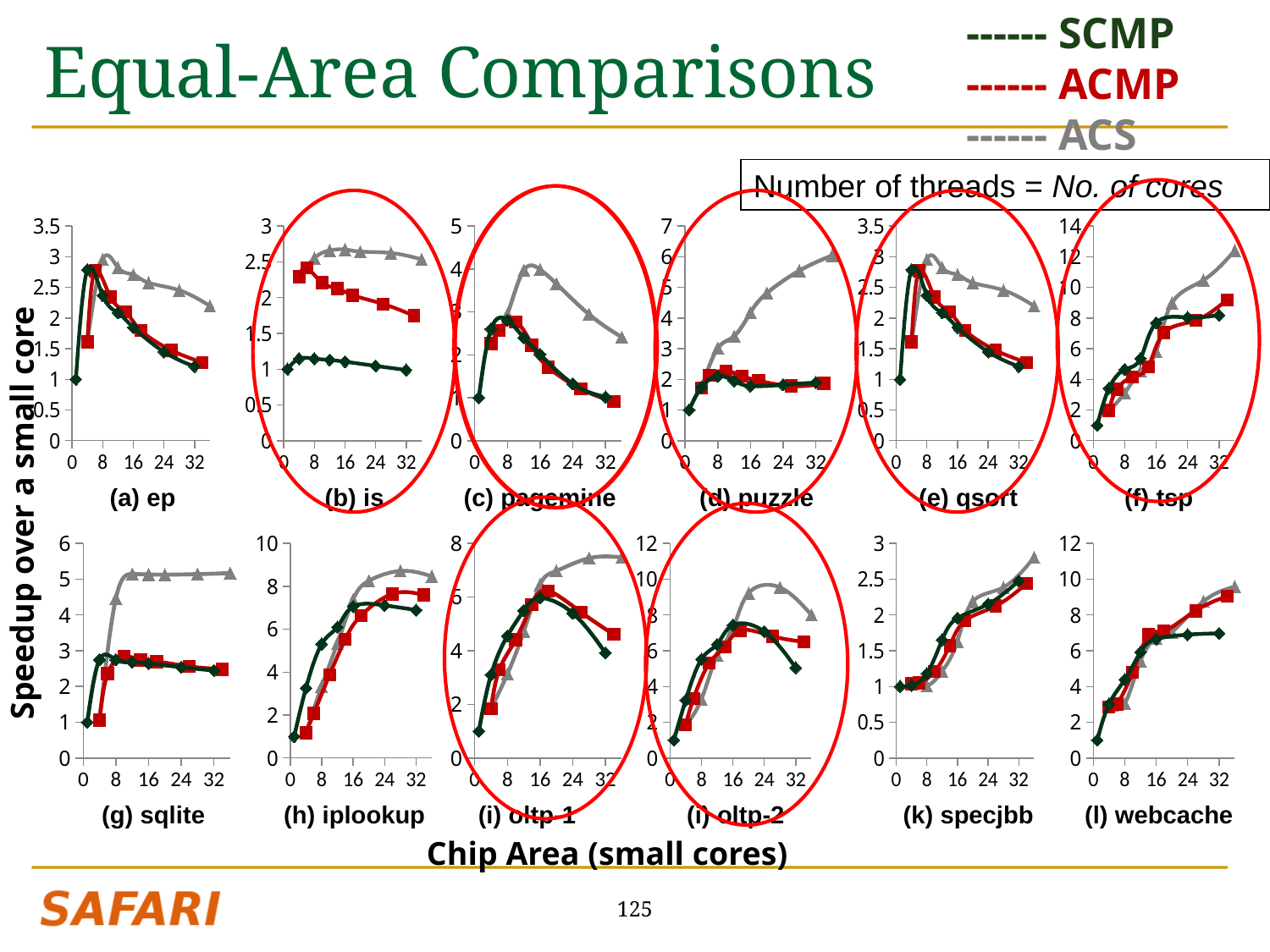
In the (k) specjbb chart, do the values rise or fall as chip area increases? rise How many benchmark panels (charts) are shown on the slide? 12 In the (b) is chart, is the ACS value at chip area 16 greater or less than 2? greater What is the label of the shared x axis? Chip Area (small cores) What kind of chart is used for the (a) ep panel? line chart In the (f) tsp chart, is the ACS value at chip area 32 greater or less than 10? greater How many series does the legend list? 3 In the (b) is chart, which series is higher at chip area 32, ACS or SCMP? ACS In the (d) puzzle chart, is the ACS value at chip area 32 greater or less than 5? greater Which series is drawn in gray according to the legend? ACS